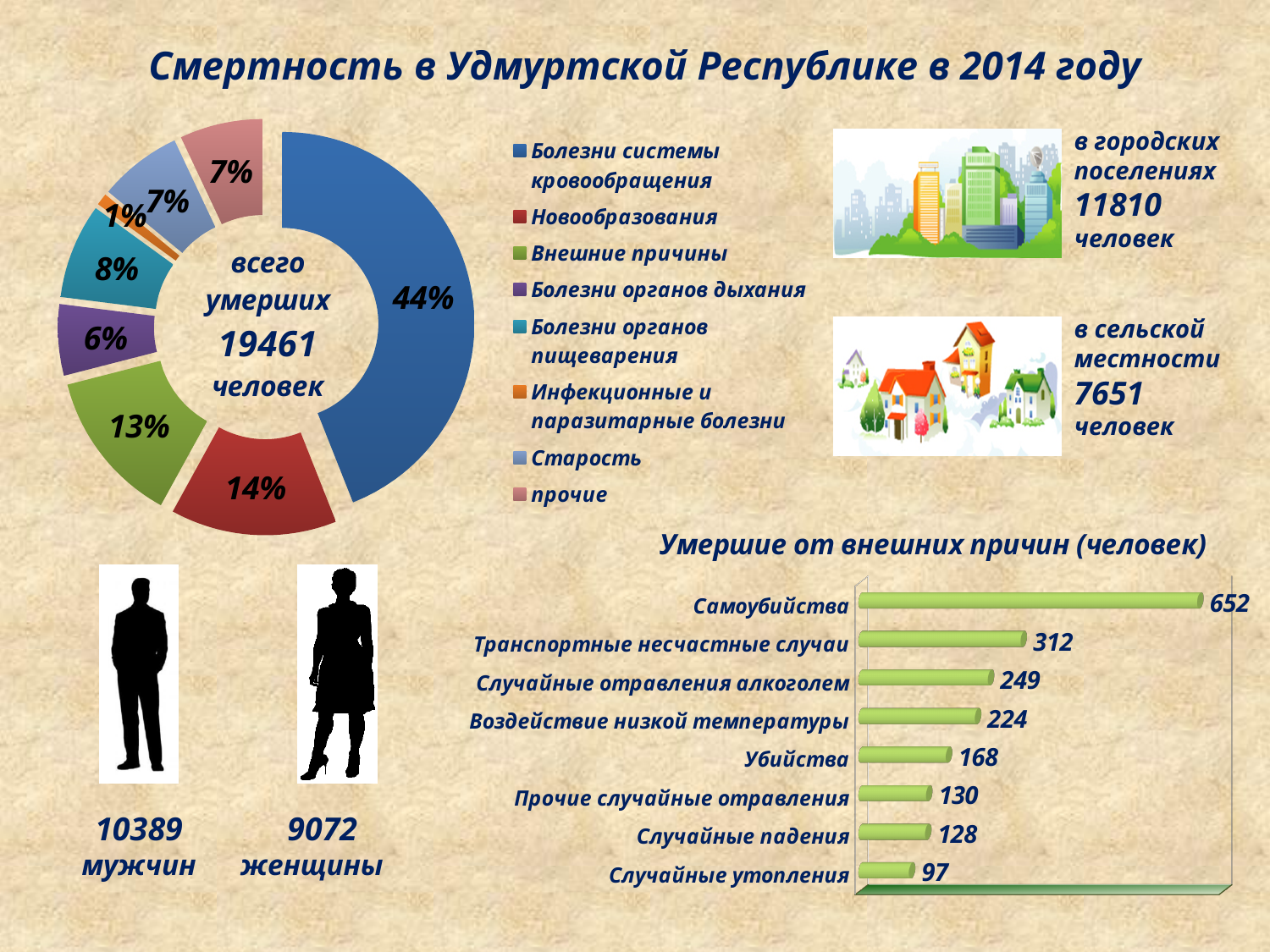
In the donut chart on the left, which cause of death has the largest share? Болезни системы кровообращения How many entries does the legend of the donut chart on the left list? 8 In the donut chart on the left, what is the difference in percentage points between 'Внешние причины' and 'Болезни органов дыхания'? 7 In the donut chart on the left, what percentage is shown for 'Новообразования'? 14% In the donut chart on the left, what share of deaths is attributed to 'Болезни системы кровообращения'? 44% In the chart 'Умершие от внешних причин (человек)', what is the difference between 'Транспортные несчастные случаи' and 'Убийства'? 144 In the chart 'Умершие от внешних причин (человек)', which category has the lowest value? Случайные утопления In the chart 'Умершие от внешних причин (человек)', what is the value for 'Самоубийства'? 652 In the chart 'Умершие от внешних причин (человек)', what is the value for 'Случайные утопления'? 97 In the chart 'Умершие от внешних причин (человек)', which is larger: 'Случайные отравления алкоголем' or 'Воздействие низкой температуры'? Случайные отравления алкоголем What type of chart is 'Умершие от внешних причин (человек)'? Bar chart In the donut chart on the left, which cause of death has the smallest share? Инфекционные и паразитарные болезни